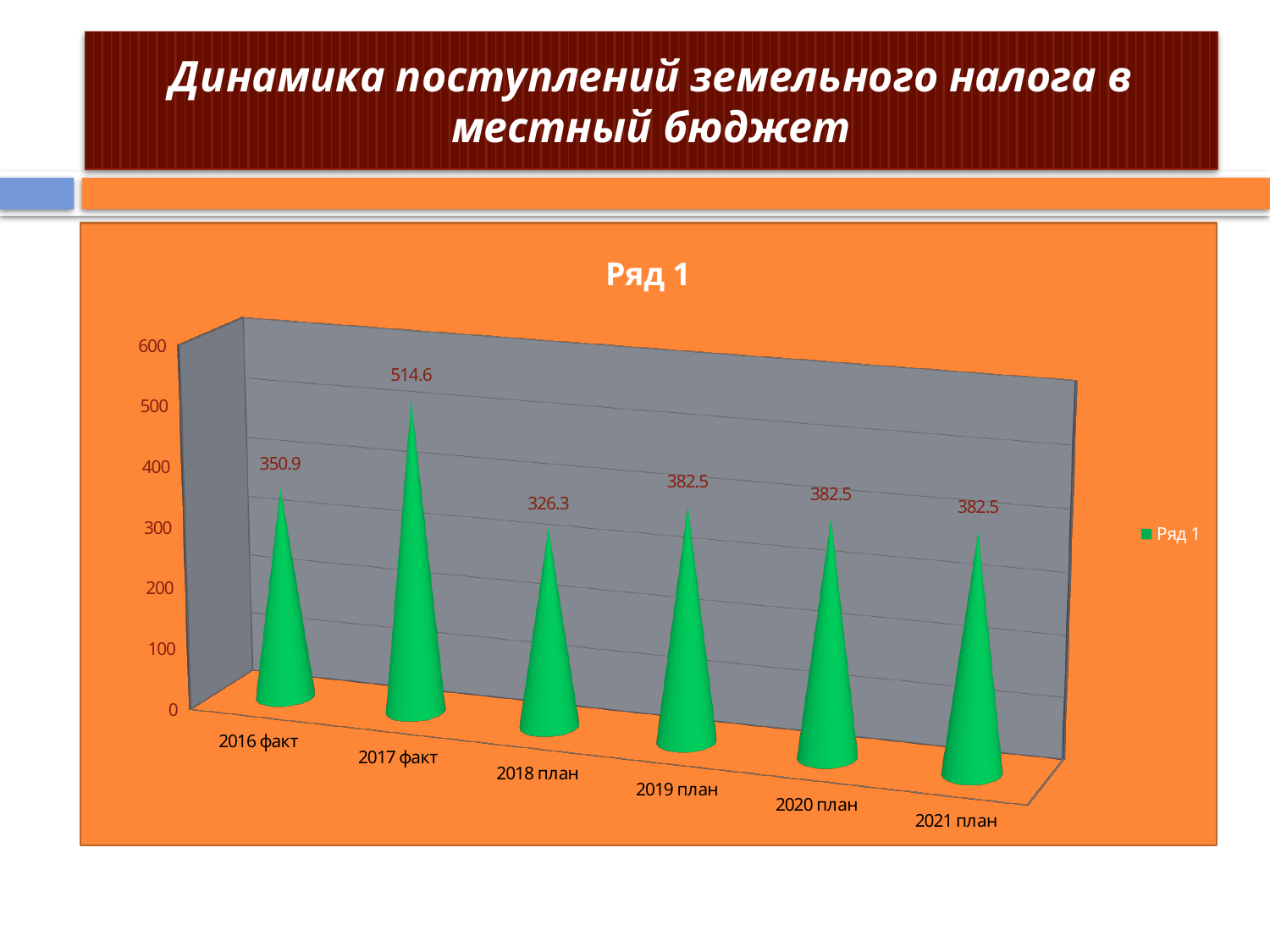
Which category has the lowest value? 2018 план How many series does the legend list? 1 What is the value for 2018 план? 326.3 What is the value for 2020 план? 382.5 Which is larger, the value for 2016 факт or the value for 2018 план? 2016 факт What is the difference between the values for 2019 план and 2018 план? 56.2 Which category has the highest value? 2017 факт What is the value for 2016 факт? 350.9 What is the difference between the values for 2017 факт and 2016 факт? 163.7 What is the title of the chart? Ряд 1 What is the value for 2017 факт? 514.6 How many categories are shown on the x axis? 6